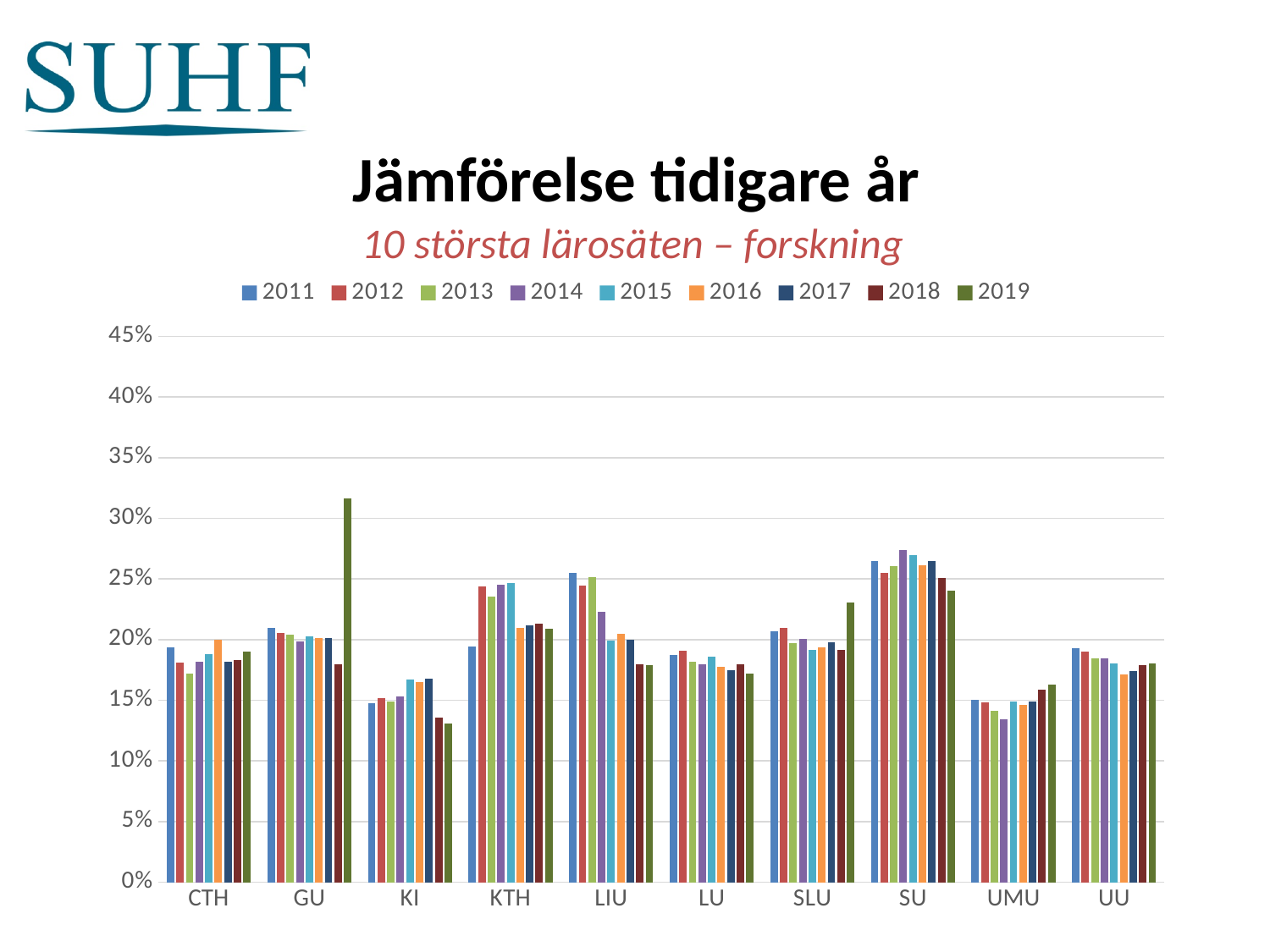
Which institution has the single tallest bar in the chart? GU Which is larger, the 2011 value for SU or the 2011 value for UMU? SU How many institutions (categories) are shown on the x axis? 10 What is the subtitle shown in red below the chart title? 10 största lärosäten – forskning Is the value for GU in 2019 greater or less than 30%? greater How many series does the legend list? 9 For GU, which year has the highest value? 2019 Is the value for KTH in 2011 greater or less than 20%? less What kind of chart is shown on the slide? bar chart Is the value for SU in 2014 greater or less than 25%? greater For CTH, which year has the lowest value? 2013